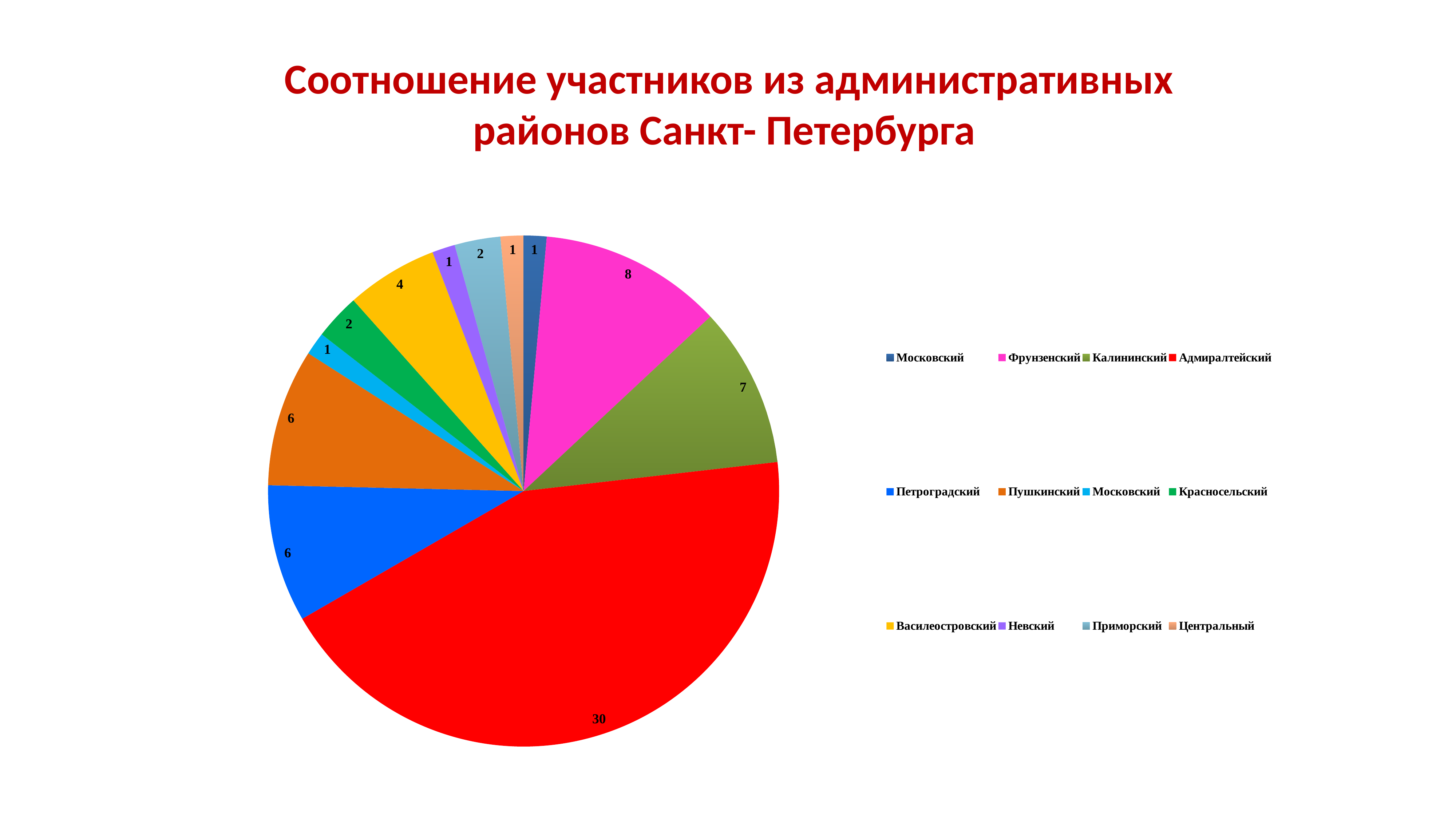
What is the value for Красносельский? 2 How many slices does the pie chart have? 12 Which district has the largest slice of the pie? Адмиралтейский Which is larger, the value for Фрунзенский or the value for Калининский? Фрунзенский What is the difference between the values for Адмиралтейский and Фрунзенский? 22 What colour is the slice for Адмиралтейский? red What is the value for Василеостровский? 4 What is the value for Адмиралтейский? 30 What is the value for Калининский? 7 What type of chart is shown on the slide? pie chart What is the value for Фрунзенский? 8 What is the difference between the values for Калининский and Василеостровский? 3